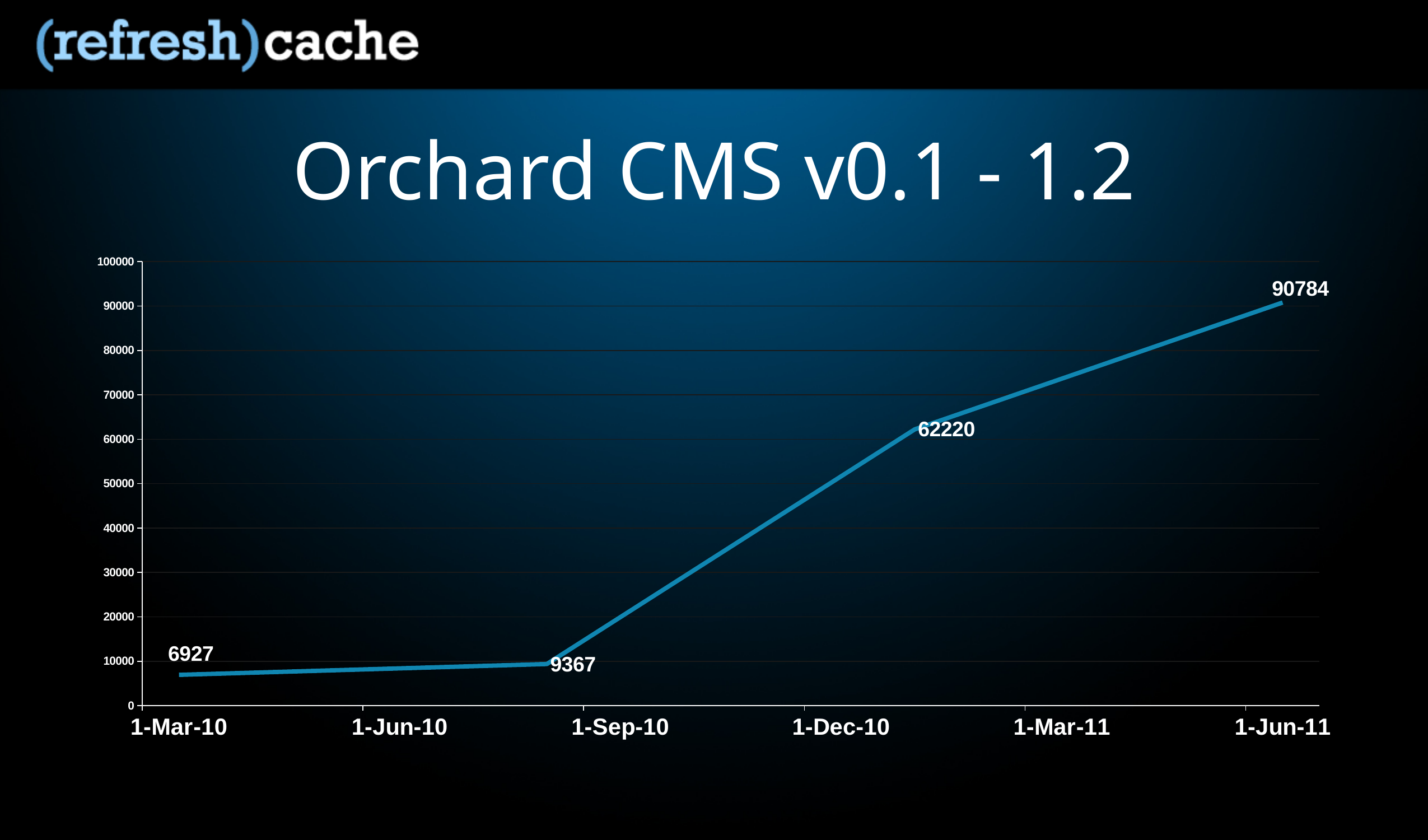
What is the title of the chart? Orchard CMS v0.1 - 1.2 What is the difference between the last data point and the third data point? 28564 Do the values rise or fall from left to right along the x axis? rise What kind of chart is shown on the slide? line chart What is the value of the third data point on the line? 62220 What is the value of the first data point on the line? 6927 How many data points are labelled on the line? 4 What is the lowest value plotted on the chart? 6927 What is the value of the second data point on the line? 9367 Is the value of the last data point greater or less than 80000? greater What is the highest value plotted on the chart? 90784 What is the value of the last data point on the line? 90784